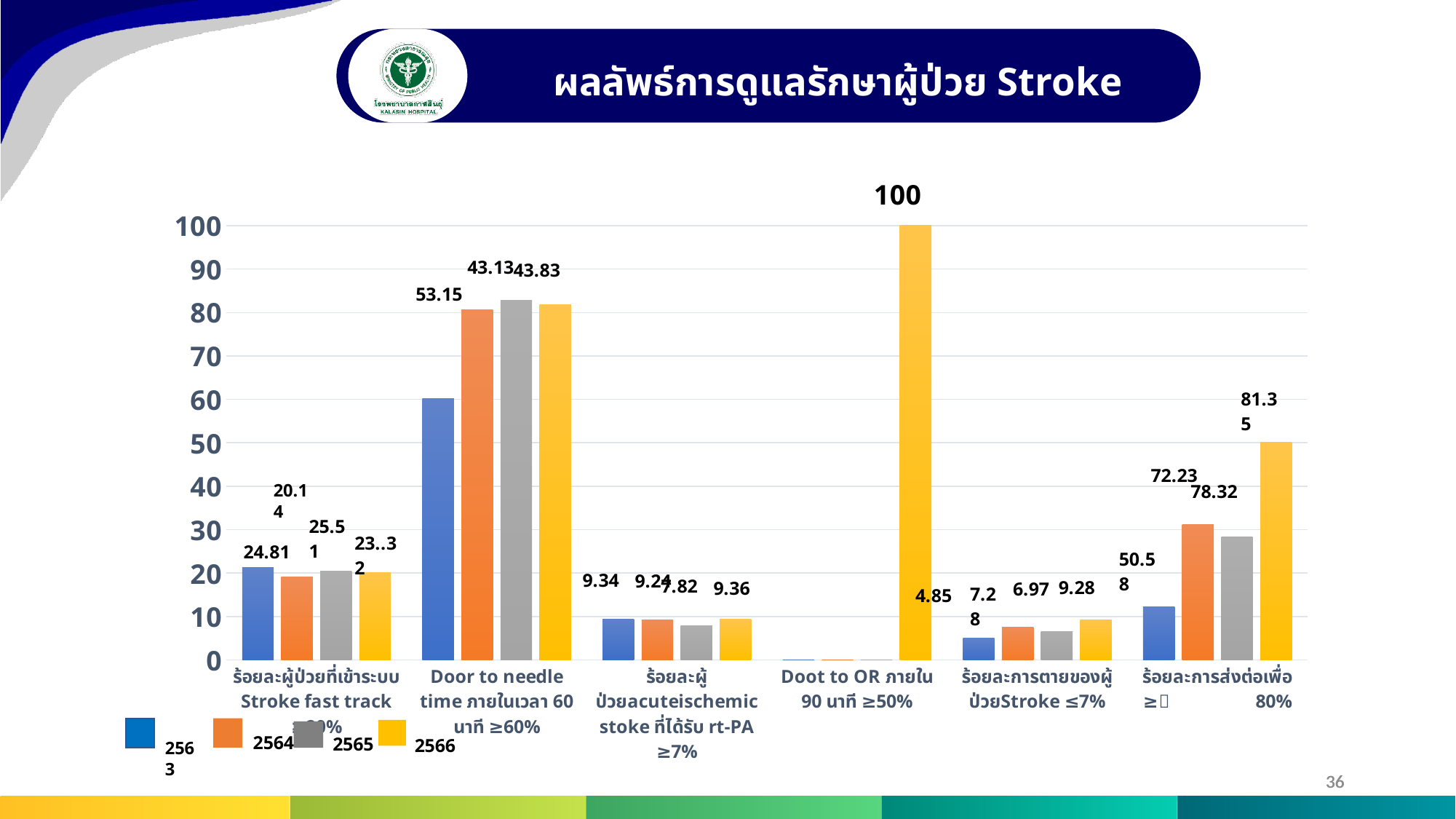
Which colour represents the year 2566 in the chart? yellow Which years are listed in the legend? 2563, 2564, 2565, 2566 What is the value for 2566 in the 'ร้อยละผู้ป่วย acute ischemic stoke ที่ได้รับ rt-PA ≥7%' category? 9.36 Is the bar for 2563 in the 'ร้อยละผู้ป่วยที่เข้าระบบ Stroke fast track' category greater or less than 30? less What kind of chart is shown on the slide? bar chart What is the value for 2563 in the 'ร้อยละผู้ป่วย acute ischemic stoke ที่ได้รับ rt-PA ≥7%' category? 9.34 How many series does the legend list? 4 Is the bar for 2565 in the 'Door to needle time ภายในเวลา 60 นาที ≥60%' category greater or less than 70? greater In the 'Door to needle time ภายในเวลา 60 นาที ≥60%' category, is the bar for 2564 or 2563 taller? 2564 How many categories are shown along the x axis? 6 Which category has the tallest bar in the chart? Doot to OR ภายใน 90 นาที ≥50% What is the value for 2566 in the 'Doot to OR ภายใน 90 นาที ≥50%' category? 100